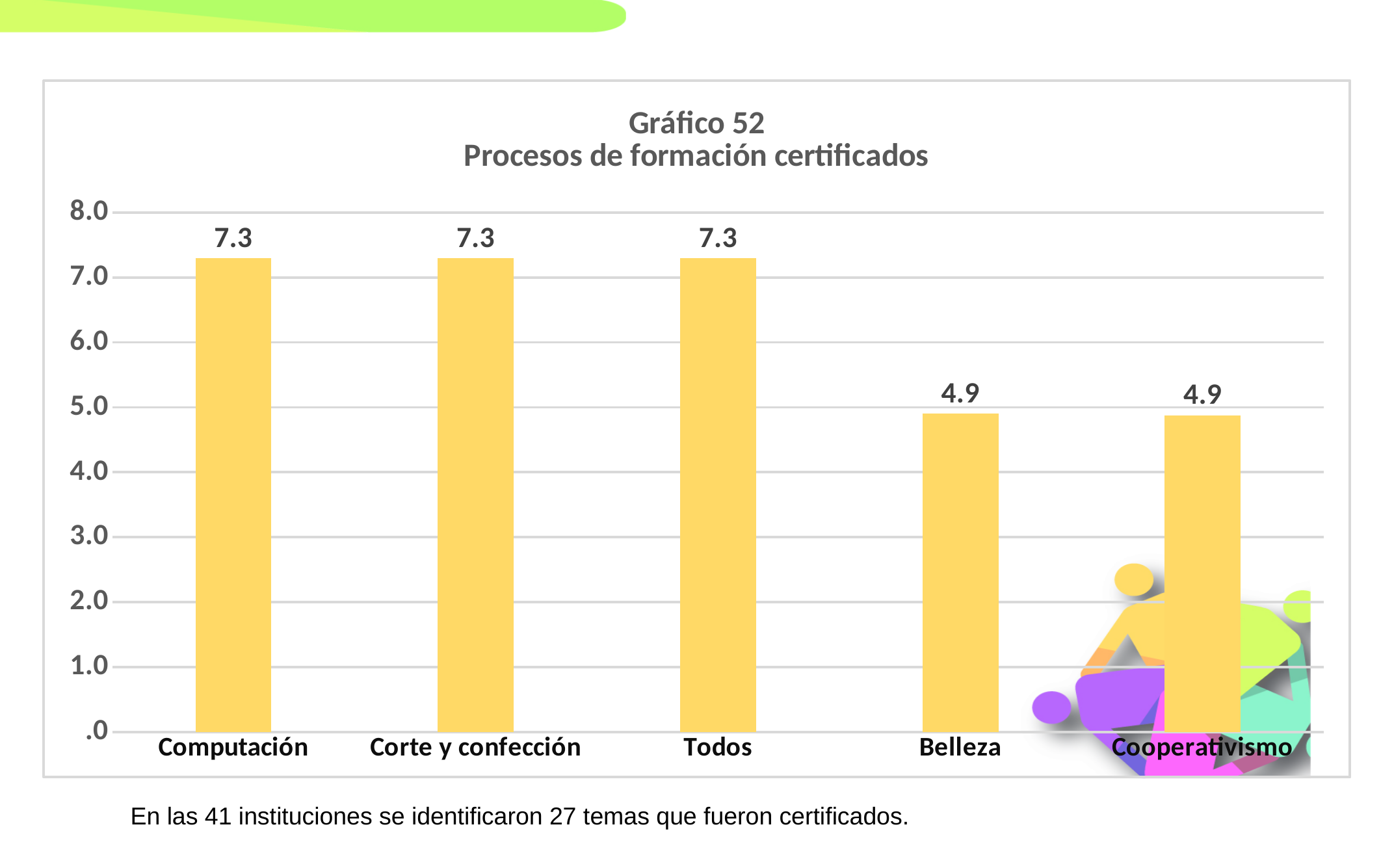
What is the value for Cooperativismo? 4.9 Is the value for Belleza greater or less than 5.0? less What is the value for Computación? 7.3 Which is larger, the value for Corte y confección or the value for Cooperativismo? Corte y confección How many categories are shown on the x axis? 5 Is the value for Todos greater or less than 7.0? greater What is the title of the chart? Gráfico 52 Procesos de formación certificados What is the value for Corte y confección? 7.3 What is the value for Belleza? 4.9 Do the values rise or fall from Computación to Cooperativismo along the x axis? fall What is the difference between the values for Todos and Belleza? 2.4 What kind of chart is shown on the slide? bar chart